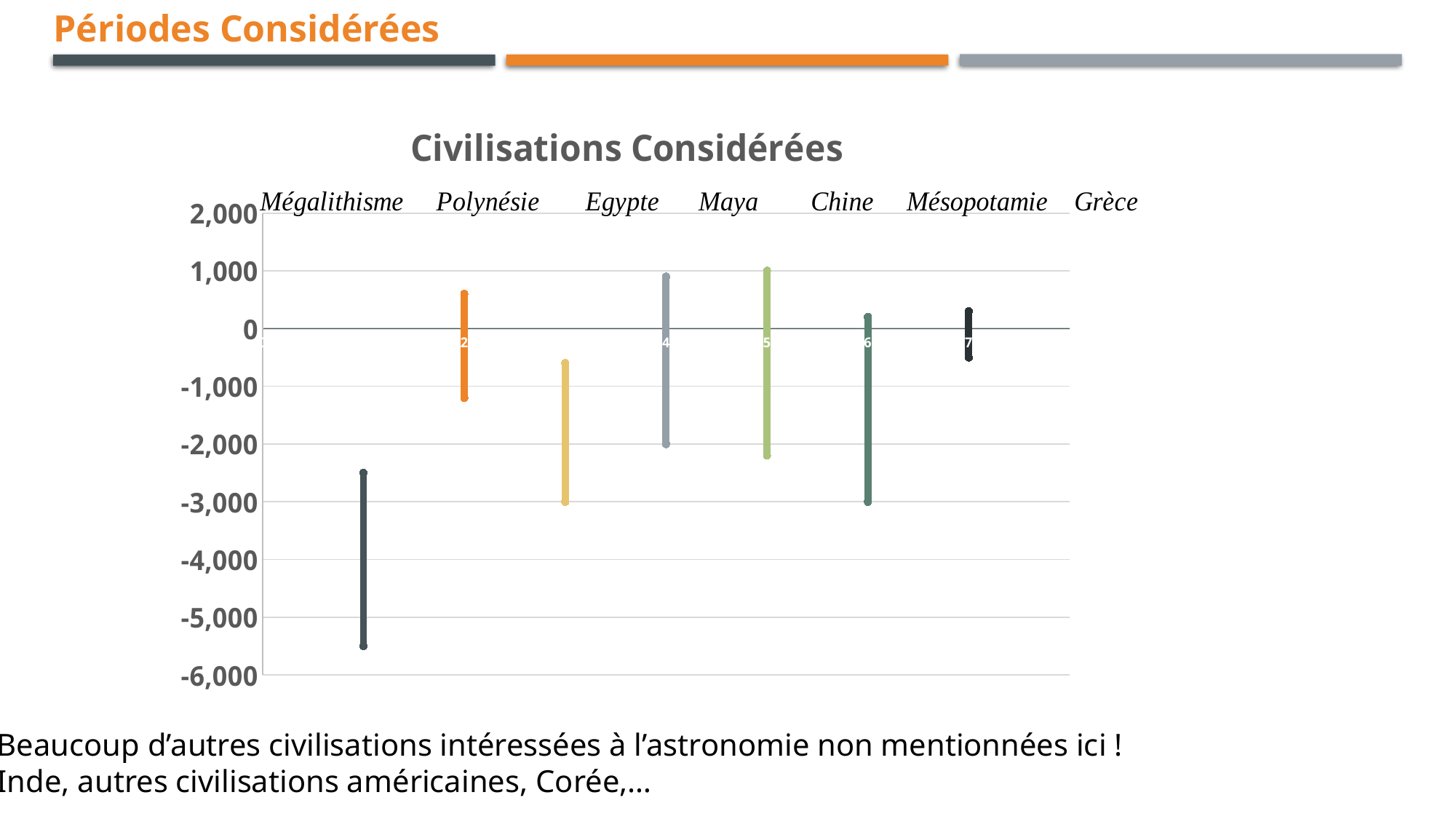
Which civilisation's bar extends the lowest on the vertical axis? Mégalithisme What colour is the second bar from the left in the chart? orange What is the lowest value shown on the vertical axis? -6,000 Which bar extends further back in time, Mégalithisme or Grèce? Mégalithisme What kind of chart is shown on the slide? bar chart How many civilisations (bars) are plotted in the chart? 7 Is the top of the Mégalithisme bar greater or less than -2,000? less Is the bottom of the Mégalithisme bar greater or less than -5,000? less What is the highest value shown on the vertical axis? 2,000 Is the top of the orange bar greater or less than 1,000? less What is the title of the chart? Civilisations Considérées